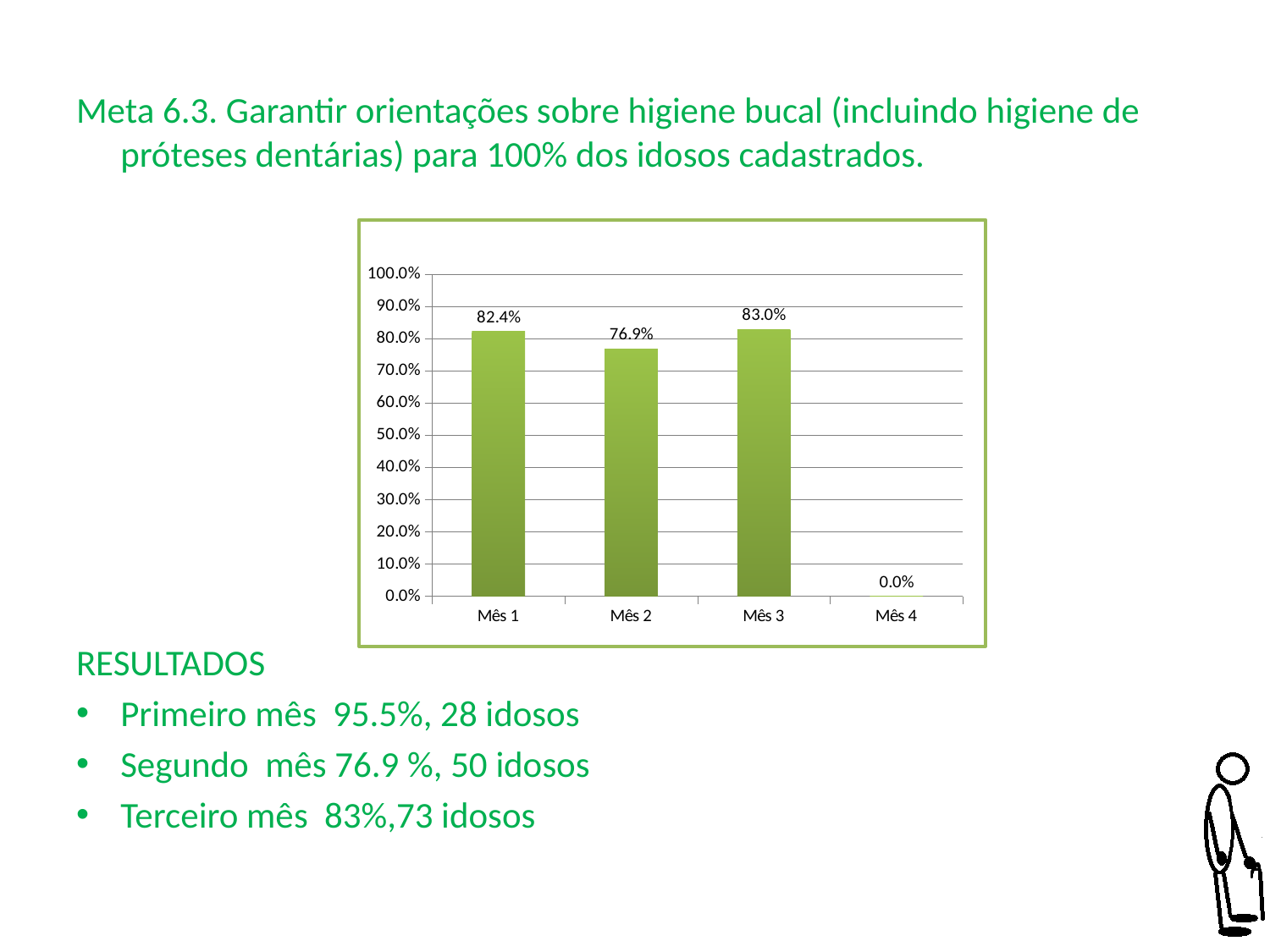
How many categories are shown on the x axis? 4 What kind of chart is shown on the slide? bar chart Which category has the lowest value? Mês 4 Which category has the highest value? Mês 3 What is the difference between the values for Mês 1 and Mês 2? 5.5% What is the value for Mês 1? 82.4% What is the value for Mês 3? 83.0% Is the value for Mês 2 greater or less than 80.0%? less Which is larger, the value for Mês 1 or the value for Mês 2? Mês 1 What is the difference between the values for Mês 3 and Mês 2? 6.1% What is the value for Mês 2? 76.9% What is the value for Mês 4? 0.0%